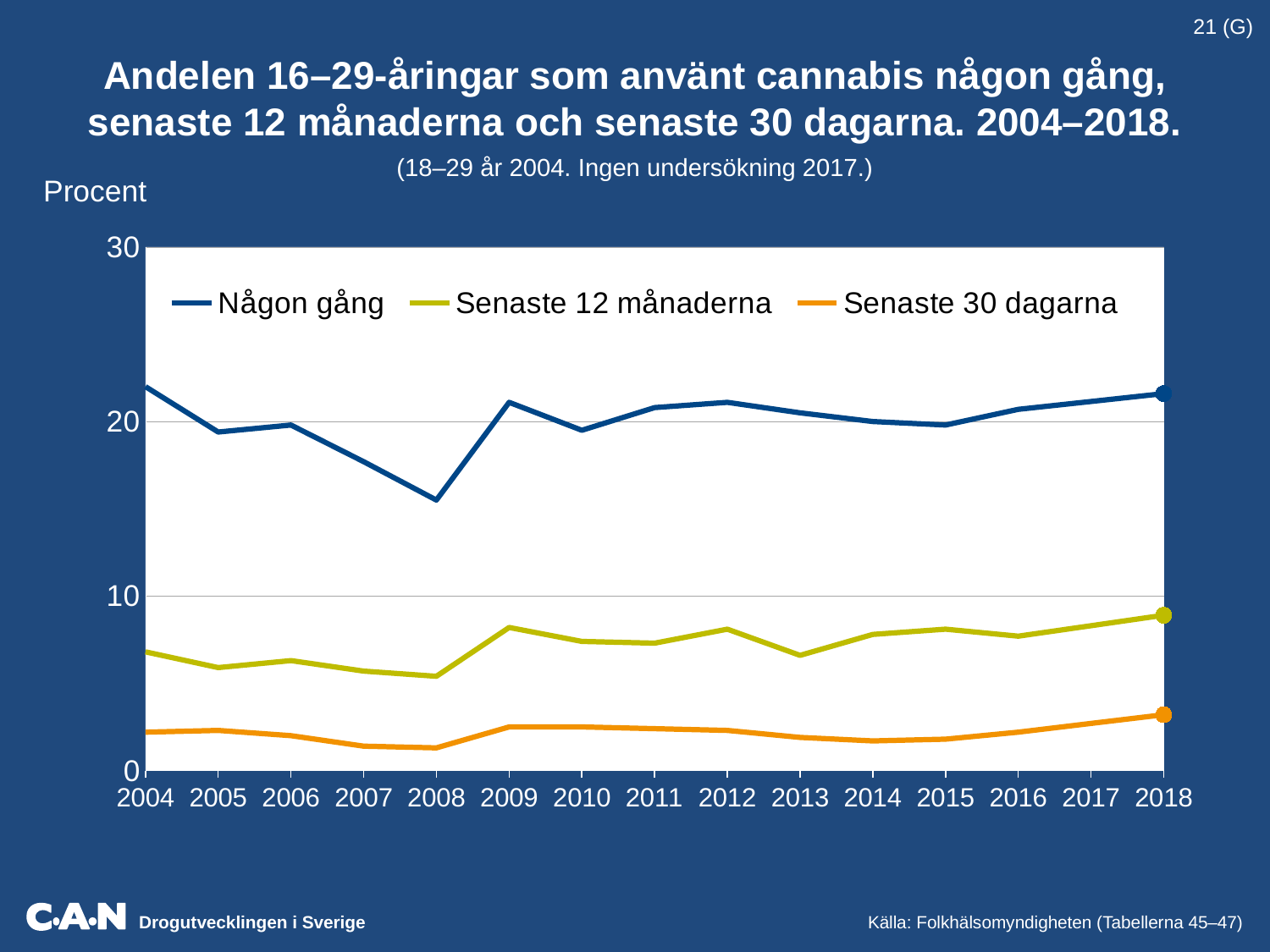
How many series does the legend list? 3 How many year labels are shown on the x axis? 15 What label is shown on the y axis of the chart? Procent Which series has the highest values throughout the chart? Någon gång Which series has the lowest values throughout the chart? Senaste 30 dagarna Which is larger for Någon gång: the value in 2004 or the value in 2008? 2004 Does the Senaste 12 månaderna line rise or fall from 2013 to 2018? rise Is the value for Någon gång in 2004 greater or less than 20? greater In which year is the value for Någon gång lowest? 2008 Is the value for Någon gång in 2008 greater or less than 20? less Is the value for Senaste 12 månaderna in 2018 greater or less than 10? less What kind of chart is shown on the slide? line chart